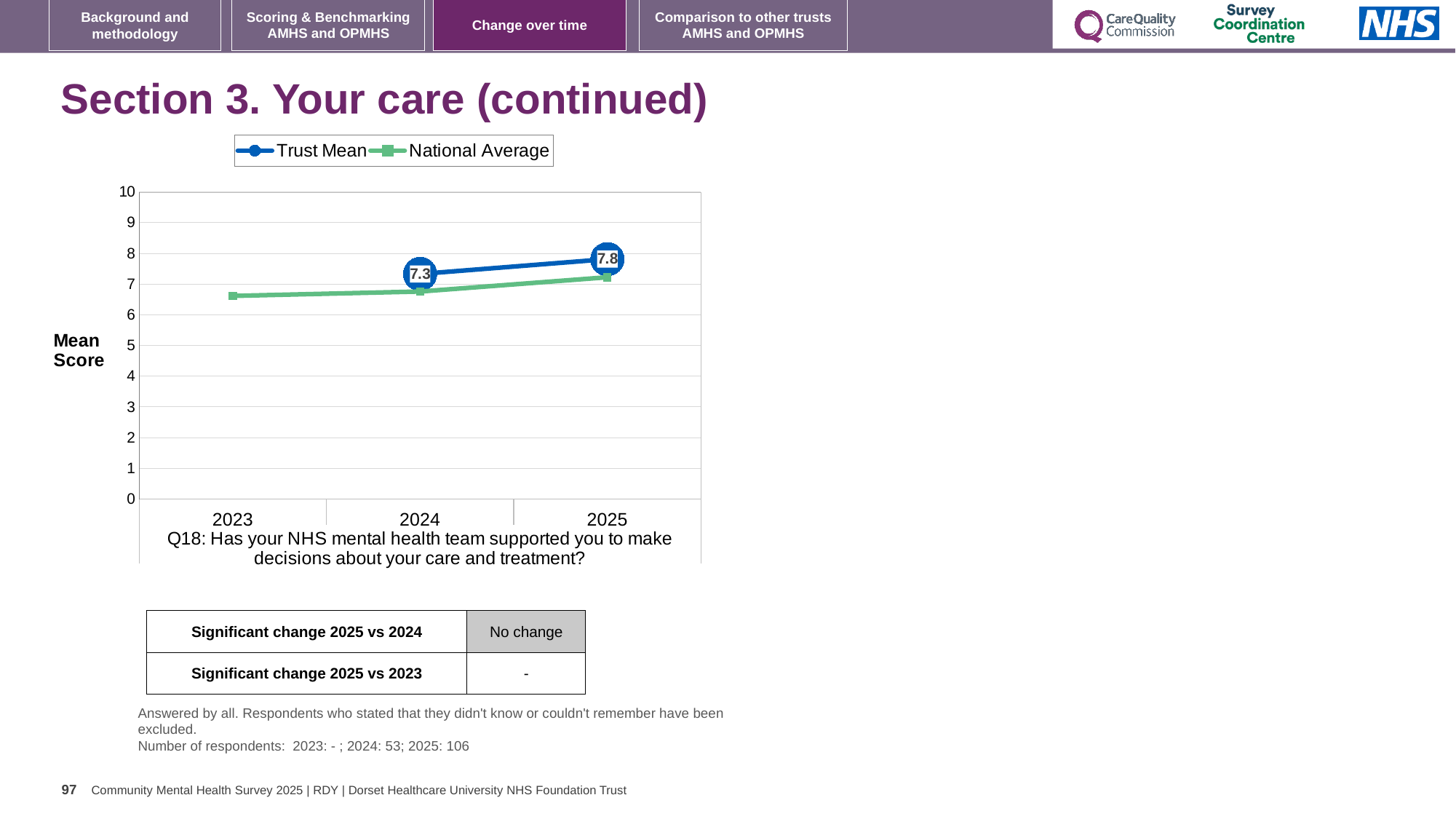
By how much did the Trust Mean score change from 2024 to 2025? 0.5 How many series does the legend list? 2 Which year has the higher Trust Mean score, 2024 or 2025? 2025 What is the Trust Mean score for 2025? 7.8 In 2025, which series has the higher value, Trust Mean or National Average? Trust Mean What are the two series named in the chart legend? Trust Mean and National Average What is the Trust Mean score for 2024? 7.3 Is the National Average value for 2023 greater or less than 7? less How many years are shown on the x axis of the chart? 3 Does the Trust Mean score rise or fall from 2024 to 2025? rise What kind of chart is shown on the slide? line chart Is the National Average value for 2025 greater or less than 8? less